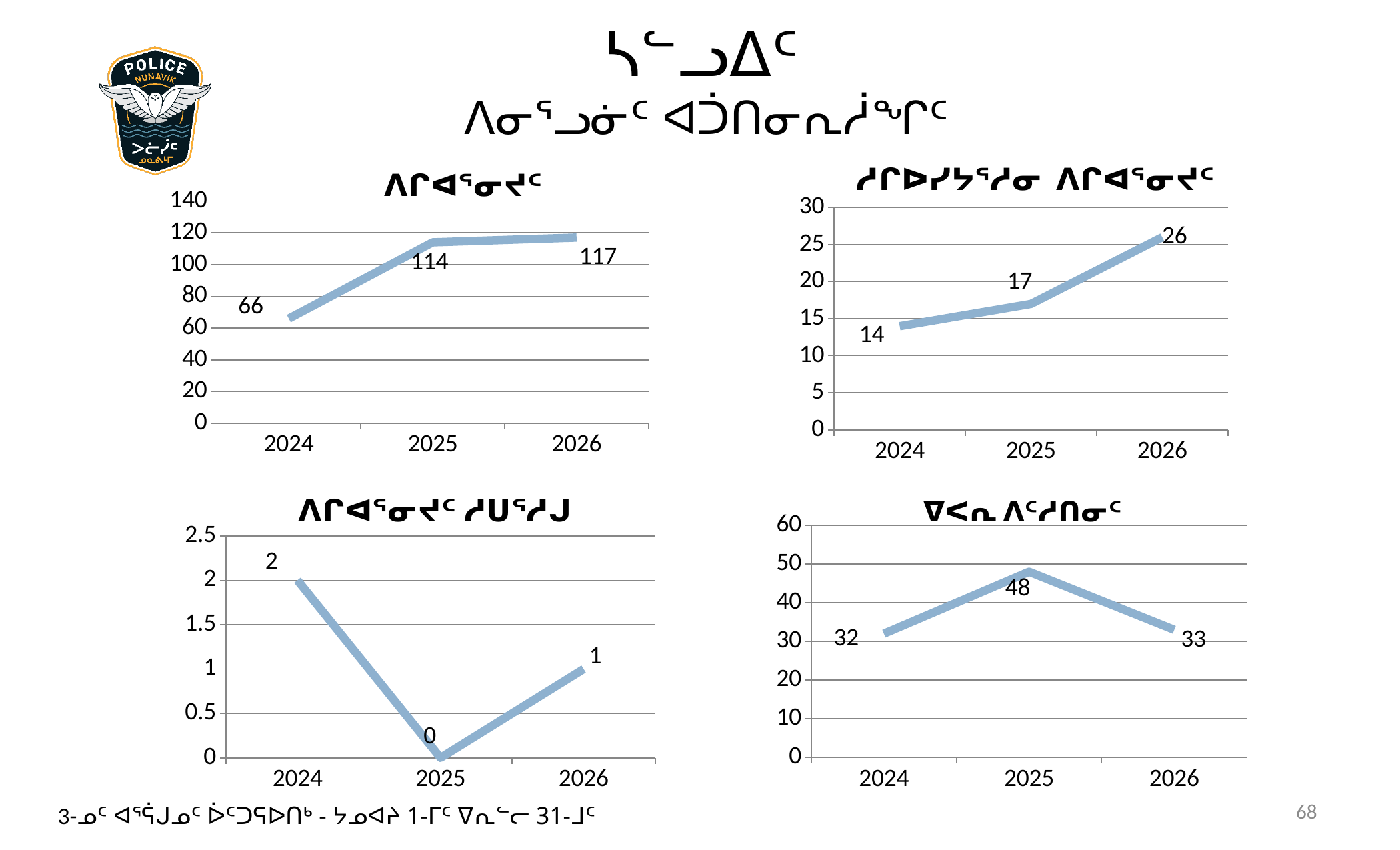
In the top-left chart, what is the difference between the 2025 and 2024 values? 48 In the top-left chart, what is the value for 2026? 117 In the bottom-left chart, what is the value for 2025? 0 In the bottom-left chart, which year has the highest value? 2024 In the top-right chart, what is the value for 2025? 17 In the top-right chart, which year has the highest value? 2026 What kind of chart is the top-left chart? line chart In the top-left chart, what is the value for 2024? 66 In the bottom-right chart, which is larger, the value for 2024 or the value for 2026? 2026 In the top-right chart, do the values rise or fall from 2024 to 2026? rise In the bottom-right chart, what is the difference between the 2025 and 2024 values? 16 In the bottom-right chart, what is the value for 2025? 48